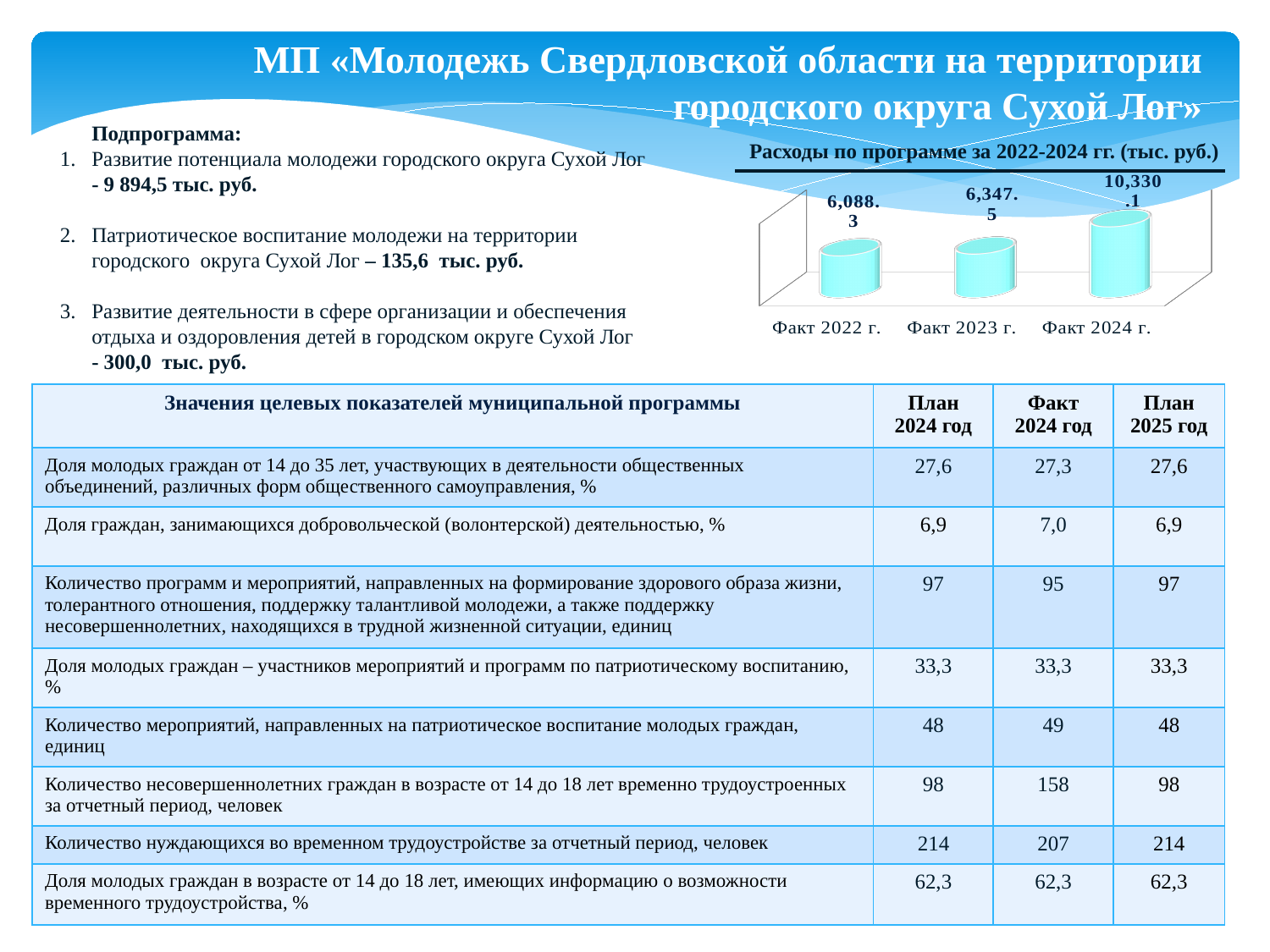
What is the value for Факт 2022 г. in the chart 'Расходы по программе за 2022-2024 гг. (тыс. руб.)'? 6,088.3 In the chart 'Расходы по программе за 2022-2024 гг. (тыс. руб.)', what is the difference between the values for Факт 2024 г. and Факт 2022 г.? 4,241.8 What kind of chart is 'Расходы по программе за 2022-2024 гг. (тыс. руб.)'? Bar chart What is the value for Факт 2024 г. in the chart 'Расходы по программе за 2022-2024 гг. (тыс. руб.)'? 10,330.1 Which category has the lowest value in the chart 'Расходы по программе за 2022-2024 гг. (тыс. руб.)'? Факт 2022 г. What is the title of the chart on the slide? Расходы по программе за 2022-2024 гг. (тыс. руб.) In the chart 'Расходы по программе за 2022-2024 гг. (тыс. руб.)', which is larger: the value for Факт 2023 г. or Факт 2024 г.? Факт 2024 г. In the chart 'Расходы по программе за 2022-2024 гг. (тыс. руб.)', what is the difference between the values for Факт 2023 г. and Факт 2022 г.? 259.2 Do the values in the chart 'Расходы по программе за 2022-2024 гг. (тыс. руб.)' rise or fall from Факт 2022 г. to Факт 2024 г.? Rise Which category has the highest value in the chart 'Расходы по программе за 2022-2024 гг. (тыс. руб.)'? Факт 2024 г. What is the value for Факт 2023 г. in the chart 'Расходы по программе за 2022-2024 гг. (тыс. руб.)'? 6,347.5 How many categories are shown in the chart 'Расходы по программе за 2022-2024 гг. (тыс. руб.)'? 3